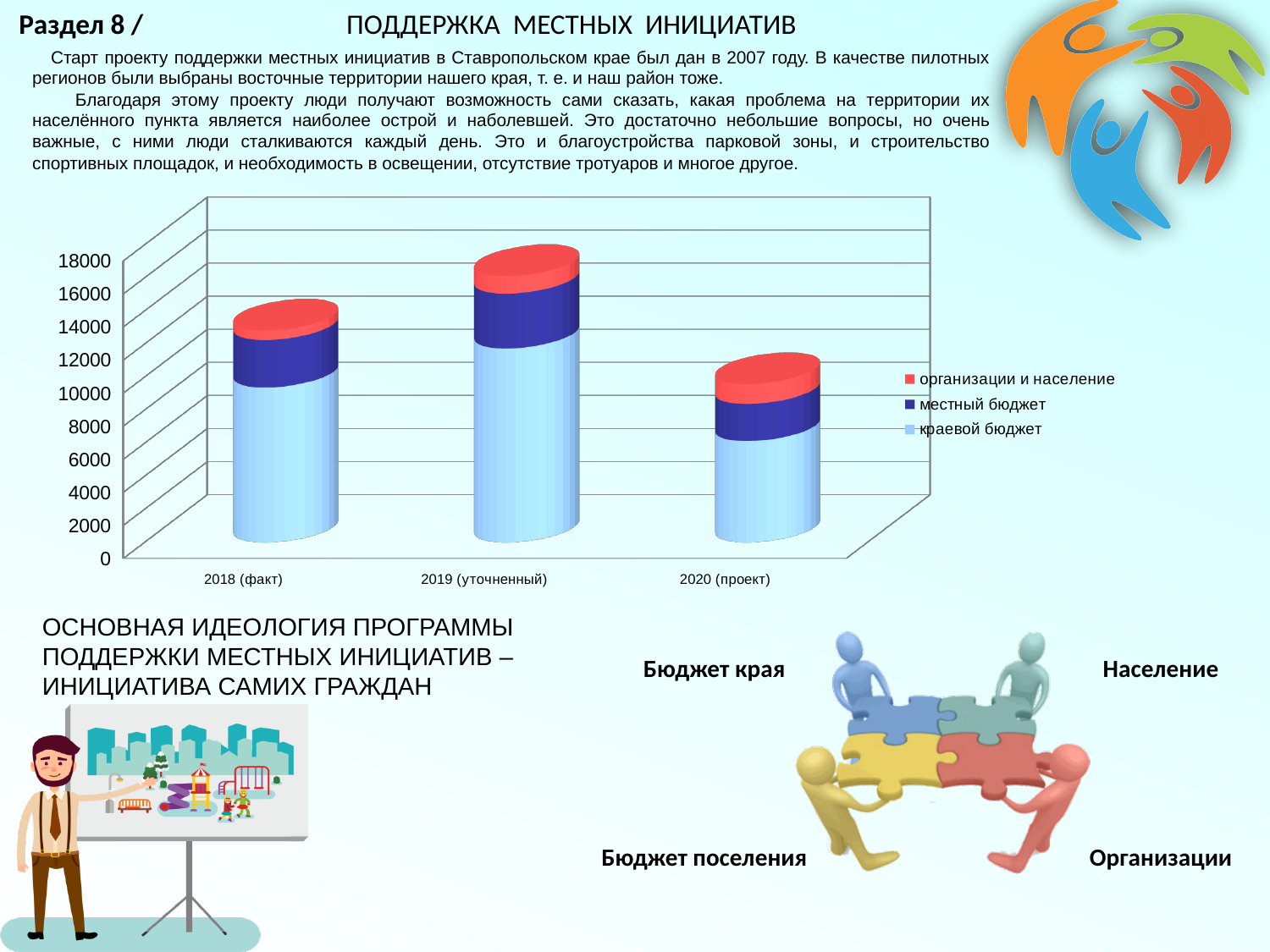
Do the total bar values rise or fall from 2019 (уточненный) to 2020 (проект)? fall How many series does the chart legend list? 3 What kind of chart is shown on the slide? stacked bar chart Which total bar is larger, 2018 (факт) or 2020 (проект)? 2018 (факт) Is the total value for 2020 (проект) greater or less than 14000? less Is the краевой бюджет value for 2019 (уточненный) greater or less than 10000? greater Which category has the highest total bar in the chart? 2019 (уточненный) Which series is shown in red in the chart legend? организации и население How many categories are shown on the x axis of the chart? 3 Is the краевой бюджет value for 2020 (проект) greater or less than 8000? less Which category has the lowest total bar in the chart? 2020 (проект)